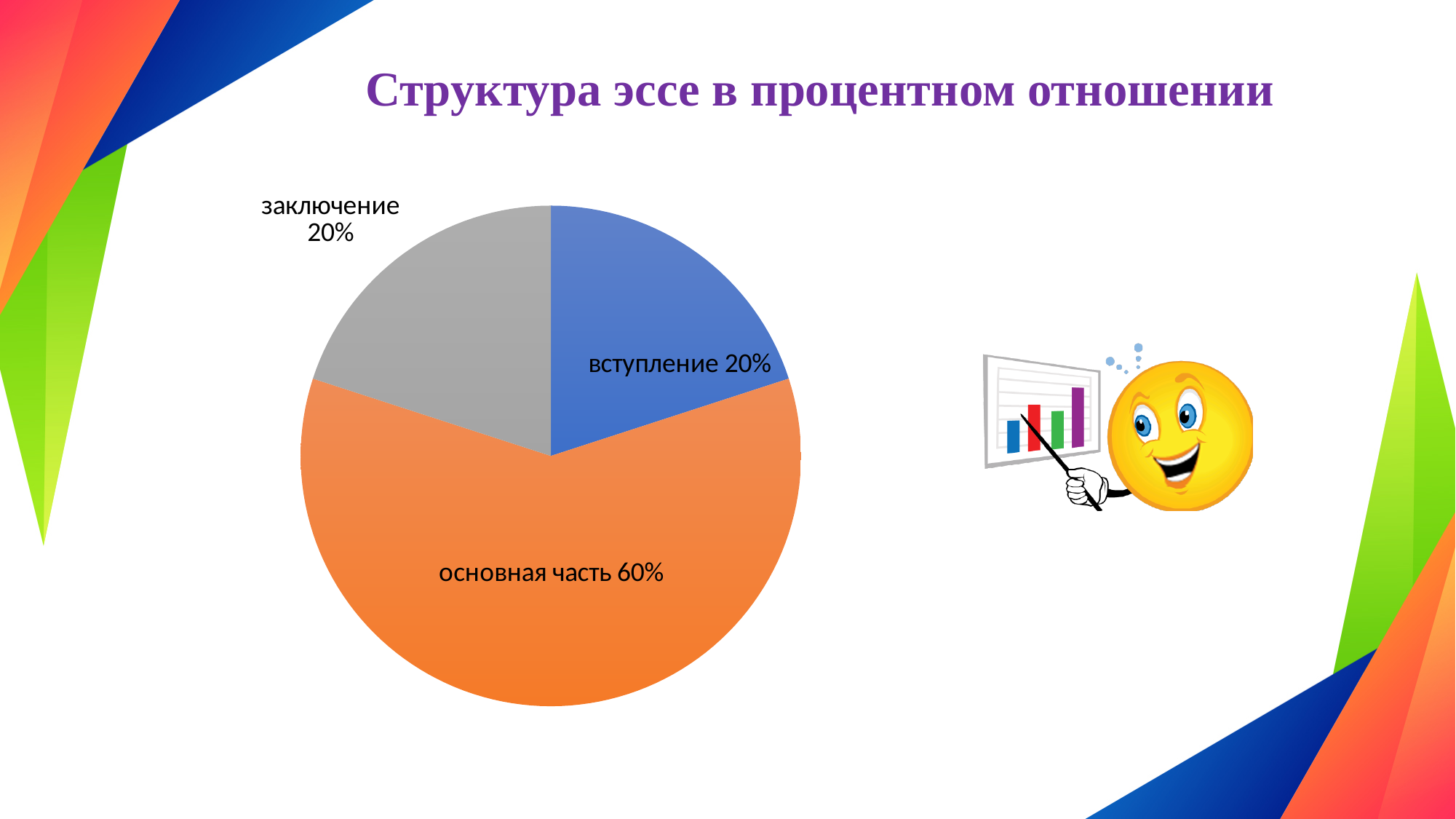
What kind of chart is shown on the slide? pie chart What is the difference between the share of основная часть and the share of вступление? 40% What share of the pie does вступление take? 20% How many slices does the pie chart have? 3 What share of the pie does основная часть take? 60% Which slice of the pie is the largest? основная часть What colour is the slice for основная часть? orange What is the title of the slide containing the chart? Структура эссе в процентном отношении What is the combined share of вступление and заключение? 40% What share of the pie does заключение take? 20% Which is larger, the share of основная часть or the share of заключение? основная часть